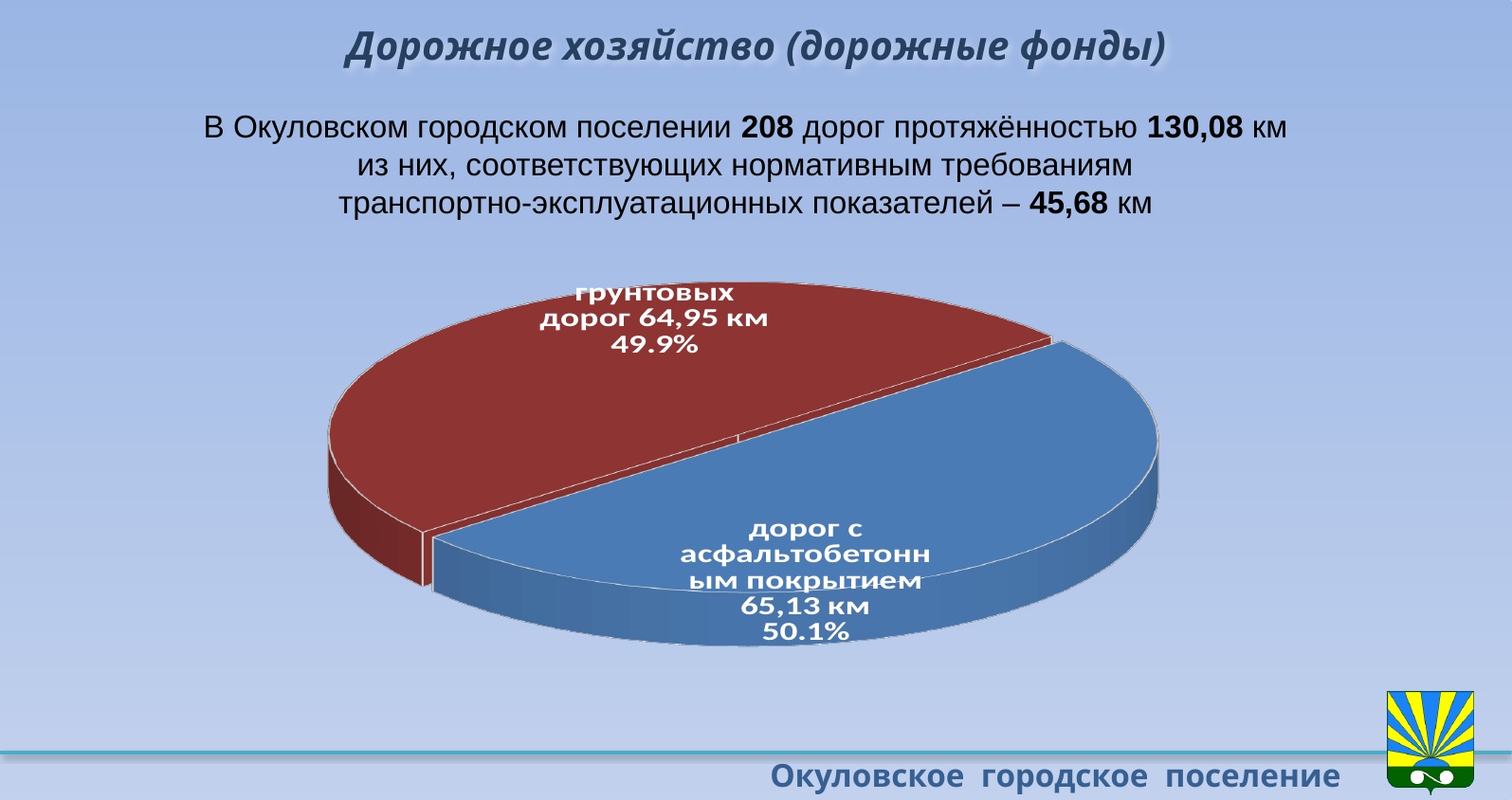
According to the printed labels, which slice is larger: грунтовых дорог or дорог с асфальтобетонным покрытием? дорог с асфальтобетонным покрытием What colour is the дорог с асфальтобетонным покрытием slice of the pie chart? blue What colour is the грунтовых дорог slice of the pie chart? red What share of the pie does the грунтовых дорог slice represent? 49.9% What kind of chart is shown on the slide? pie chart What is the length of грунтовых дорог shown on the pie chart? 64,95 км What is the length of дорог с асфальтобетонным покрытием shown on the pie chart? 65,13 км What is the difference in length between дорог с асфальтобетонным покрытием and грунтовых дорог according to the pie chart labels? 0,18 км How many slices does the pie chart have? 2 What share of the pie does the дорог с асфальтобетонным покрытием slice represent? 50.1% What is the combined length of the two road types shown in the pie chart? 130,08 км